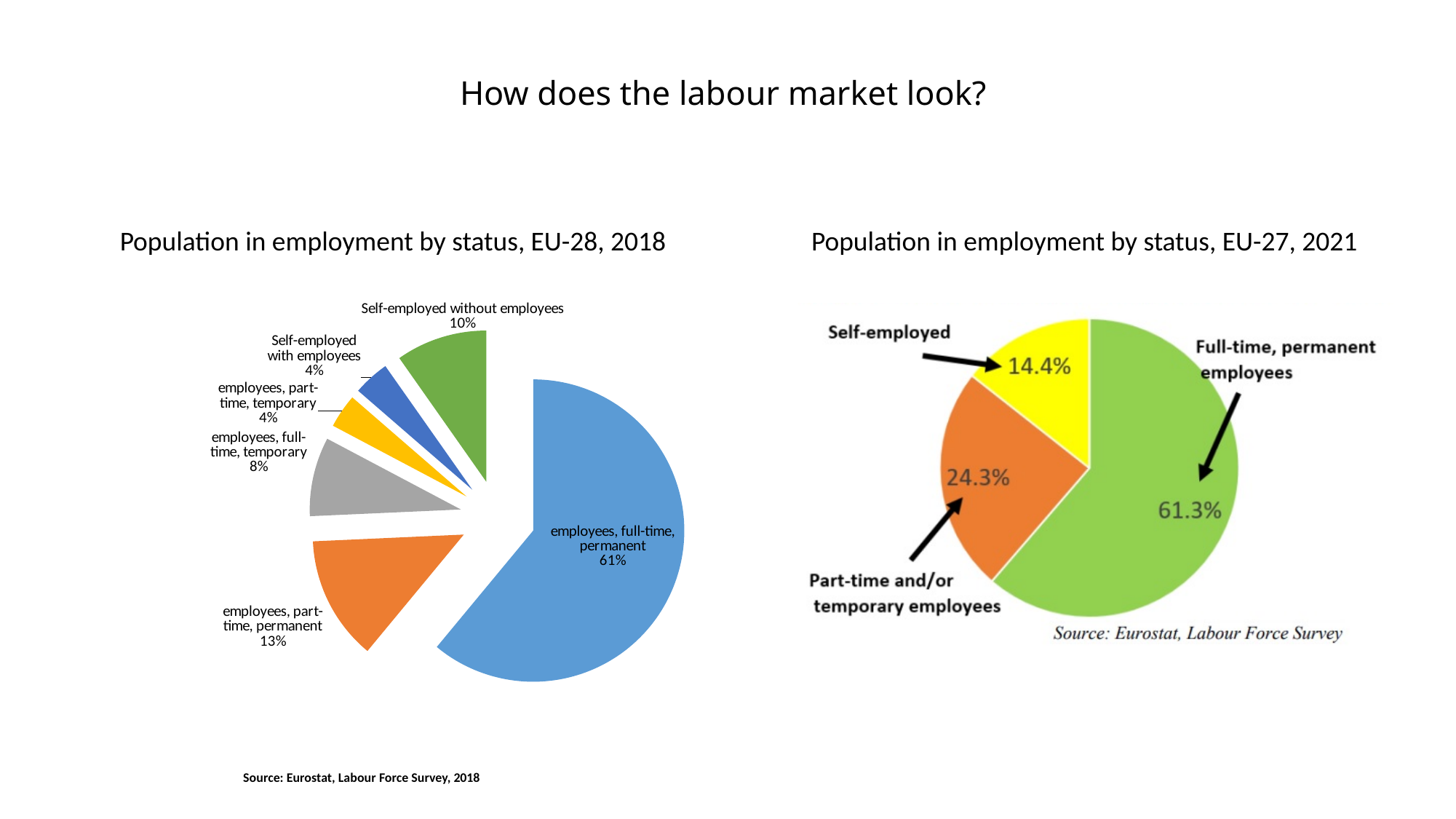
What kind of chart is the 'Population in employment by status, EU-27, 2021' chart? pie chart In the 'Population in employment by status, EU-28, 2018' chart, which category has the largest share? employees, full-time, permanent In the 'Population in employment by status, EU-28, 2018' chart, what share is shown for employees, part-time, permanent? 13% In the 'Population in employment by status, EU-27, 2021' chart, what share is shown for part-time and/or temporary employees? 24.3% In the 'Population in employment by status, EU-27, 2021' chart, what share is shown for self-employed? 14.4% In the 'Population in employment by status, EU-28, 2018' chart, what share is shown for employees, full-time, temporary? 8% In the 'Population in employment by status, EU-28, 2018' chart, what share is shown for employees, full-time, permanent? 61% In the 'Population in employment by status, EU-27, 2021' chart, what share is shown for full-time, permanent employees? 61.3% In the 'Population in employment by status, EU-27, 2021' chart, which category has the smallest share? Self-employed In the 'Population in employment by status, EU-28, 2018' chart, what is the difference between the shares for employees, part-time, permanent and employees, full-time, temporary? 5% In the 'Population in employment by status, EU-28, 2018' chart, what share is shown for self-employed without employees? 10% In the 'Population in employment by status, EU-28, 2018' chart, how many categories are shown? 6